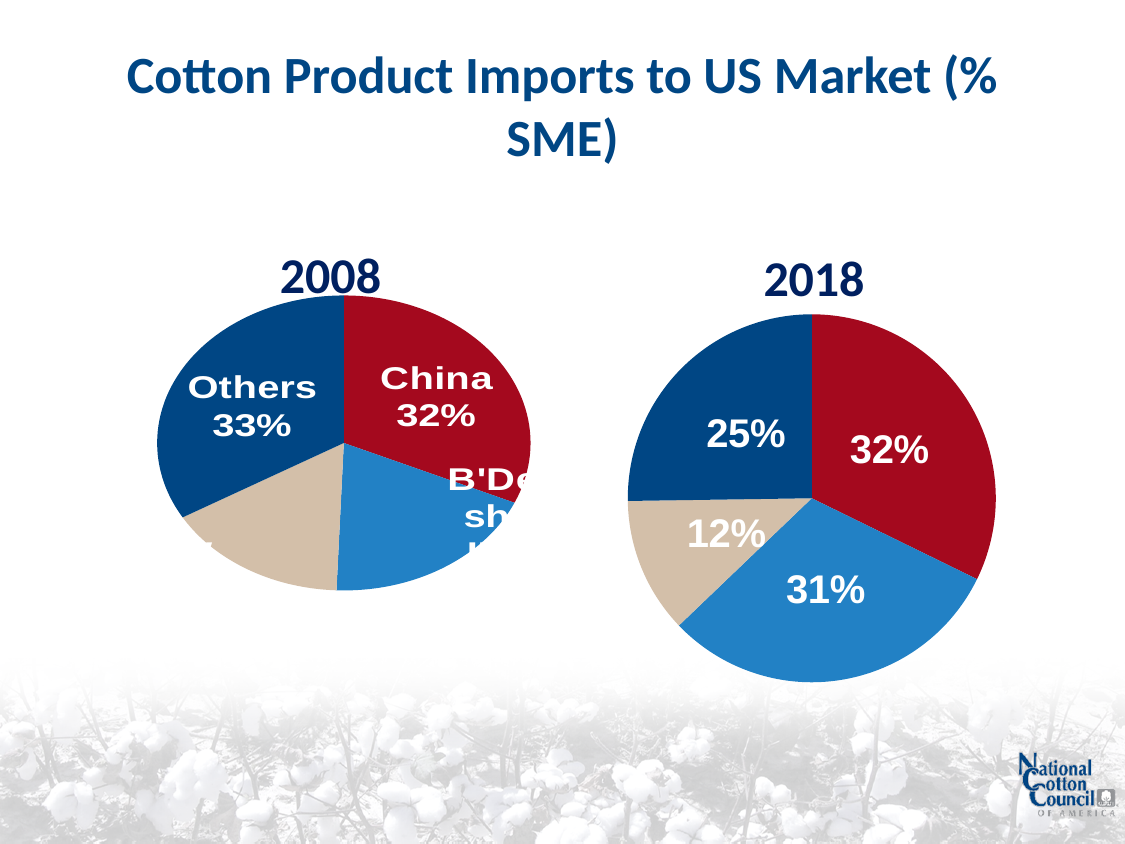
In the 2008 pie chart, what share is labelled Others? 33% In the 2008 pie chart, what is the difference between the Others share and the China share? 1 percentage point In the 2018 pie chart, what is the difference between the red slice (32%) and the tan slice (12%)? 20 percentage points In the 2018 pie chart, what share is shown on the dark blue slice? 25% In the 2008 pie chart, what share of cotton product imports came from China? 32% In the 2018 pie chart, what is the value of the largest slice? 32% How many slices does the 2018 pie chart have? 4 In the 2008 pie chart, which is larger, the Others slice or the China slice? Others In the 2018 pie chart, what is the value of the smallest slice? 12% What kind of chart is used for the 2008 data on the slide? pie chart In the 2018 pie chart, what share is shown on the light blue slice? 31% What is the title of the slide containing the two pie charts? Cotton Product Imports to US Market (% SME)